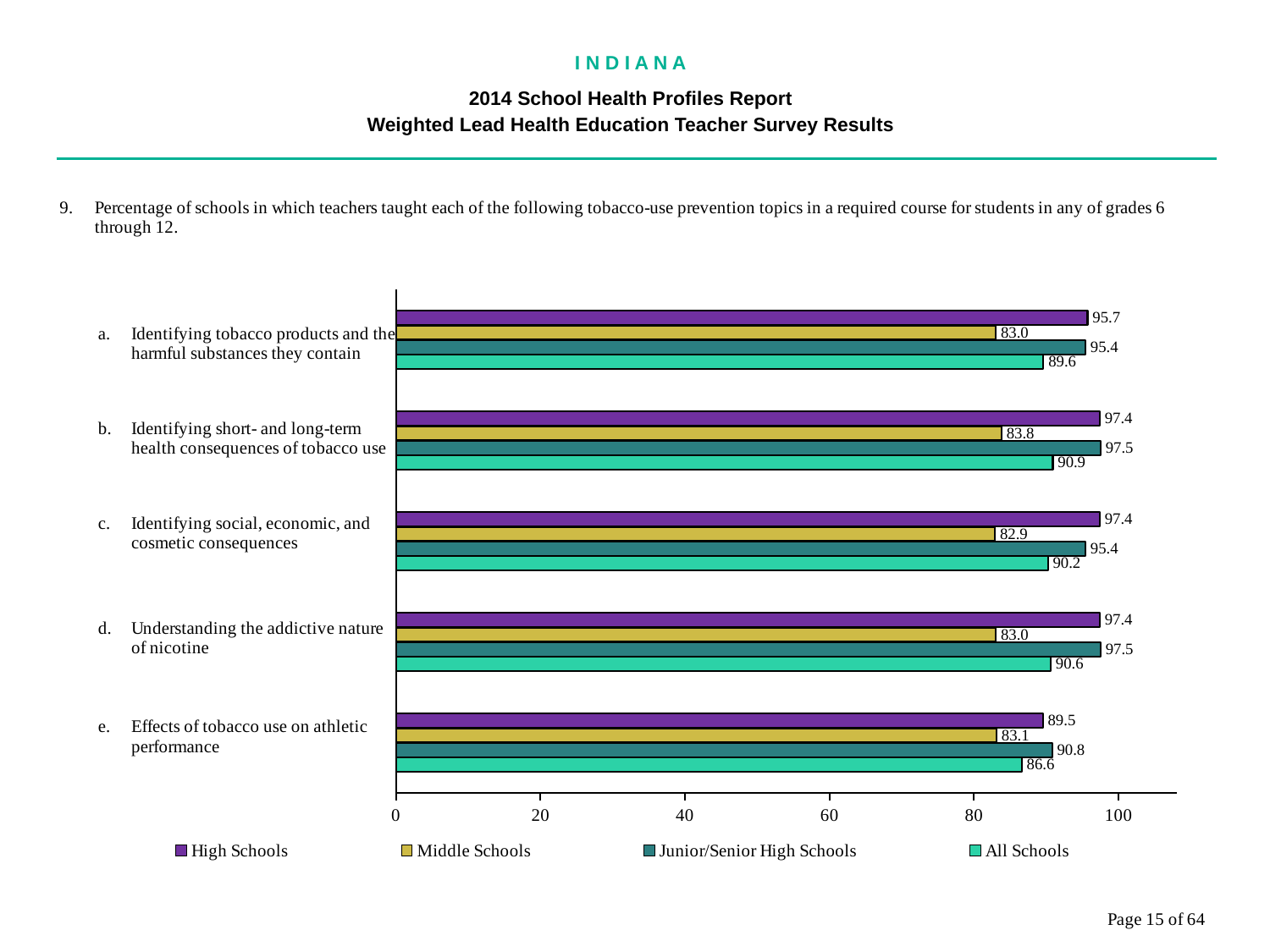
For 'Effects of tobacco use on athletic performance', which is larger: the High Schools value or the Junior/Senior High Schools value? Junior/Senior High Schools What is the value for High Schools for 'Identifying tobacco products and the harmful substances they contain'? 95.7 How many series does the legend list? 4 Which topic has the lowest value for All Schools? Effects of tobacco use on athletic performance What kind of chart is shown on the slide? Bar chart Which topic has the lowest value for High Schools? Effects of tobacco use on athletic performance What is the value for Middle Schools for 'Identifying short- and long-term health consequences of tobacco use'? 83.8 How many topics (categories) are shown in the chart? 5 Which series is shown in purple in the legend? High Schools What is the difference between the High Schools and Middle Schools values for 'Identifying social, economic, and cosmetic consequences'? 14.5 What is the value for All Schools for 'Effects of tobacco use on athletic performance'? 86.6 What is the value for Junior/Senior High Schools for 'Understanding the addictive nature of nicotine'? 97.5